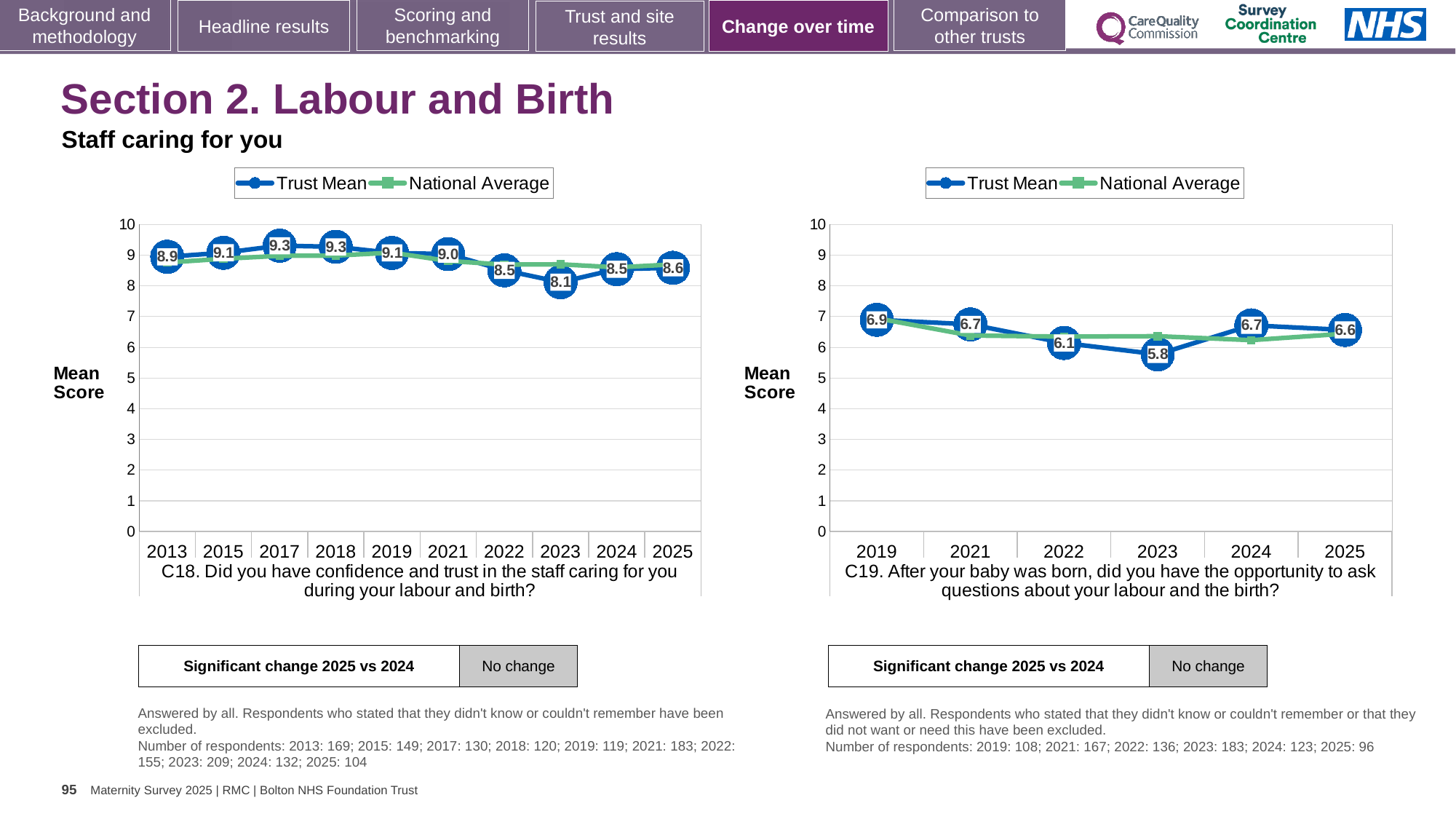
In the C18 chart on the left, which year has the lowest Trust Mean score? 2023 In the C18 chart on the left, what is the difference between the Trust Mean scores for 2018 and 2023? 1.2 In the C19 chart on the right, what is the Trust Mean score for 2019? 6.9 In the C19 chart on the right, is the Trust Mean score for 2024 larger than the score for 2022? Yes In the C19 chart on the right, which year has the lowest Trust Mean score? 2023 In the C18 chart on the left, how many years are shown on the x axis? 10 What kind of chart is the C18 chart on the left? Line chart In the C18 chart on the left, what is the Trust Mean score for 2023? 8.1 How many series does the legend of the C19 chart on the right list? 2 In the C19 chart on the right, is the National Average for 2023 greater or less than 7? less In the C18 chart on the left, what is the Trust Mean score for 2025? 8.6 In the C19 chart on the right, which year has the highest Trust Mean score? 2019